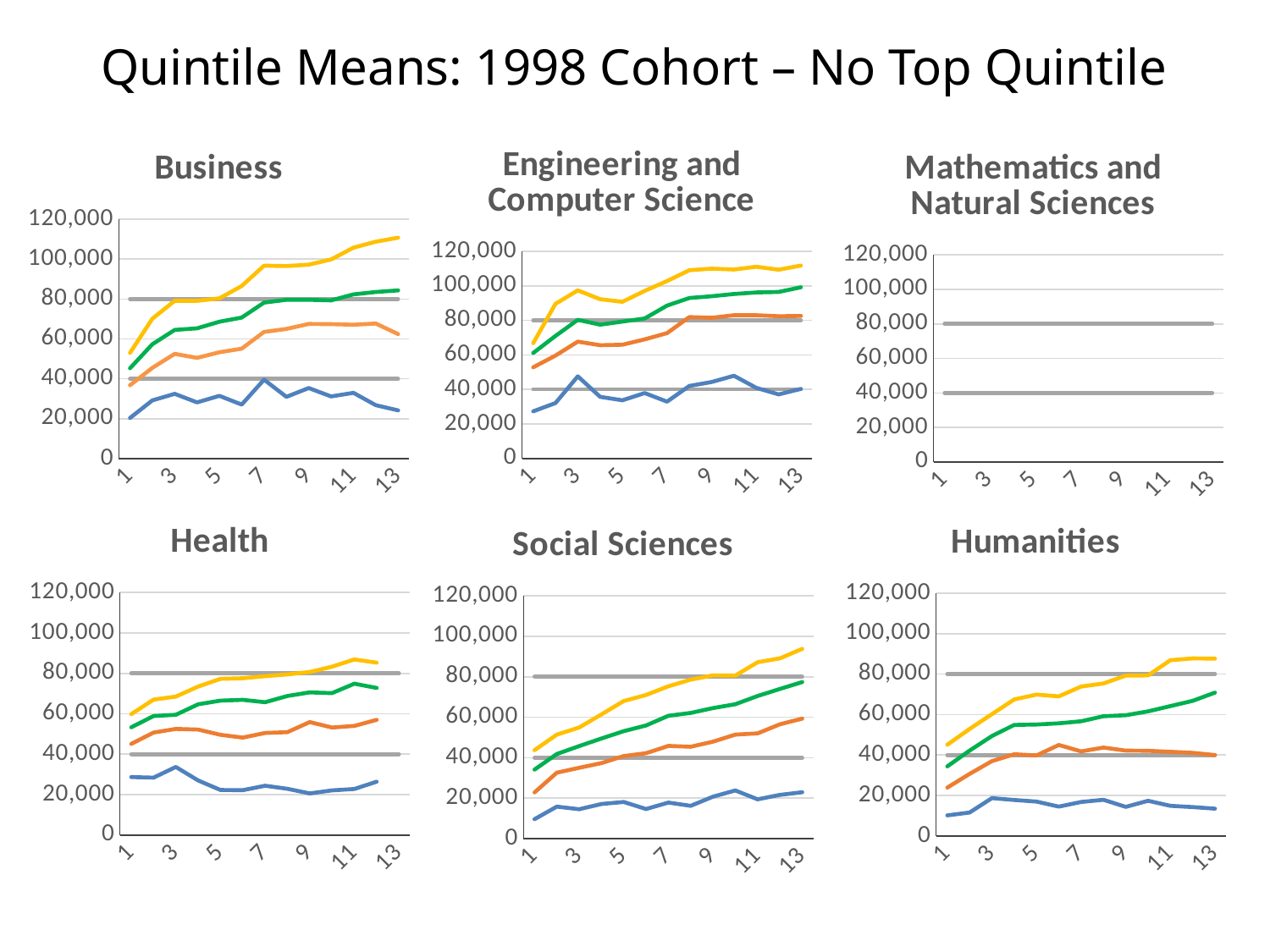
In the Engineering and Computer Science chart, is the value of the yellow line at point 13 greater or less than 100,000? greater In the Business chart, is the value of the yellow line at point 13 greater or less than 100,000? greater What kind of chart is the Business chart? line chart In the Business chart, is the value of the blue line at point 13 greater or less than 40,000? less Which chart on the slide shows only the two gray reference lines and no colored data lines? Mathematics and Natural Sciences In the Humanities chart, does the green line generally rise or fall from point 1 to point 13? rises How many charts are shown on the slide? 6 In the Engineering and Computer Science chart, does the yellow line generally rise or fall from point 1 to point 13? rises